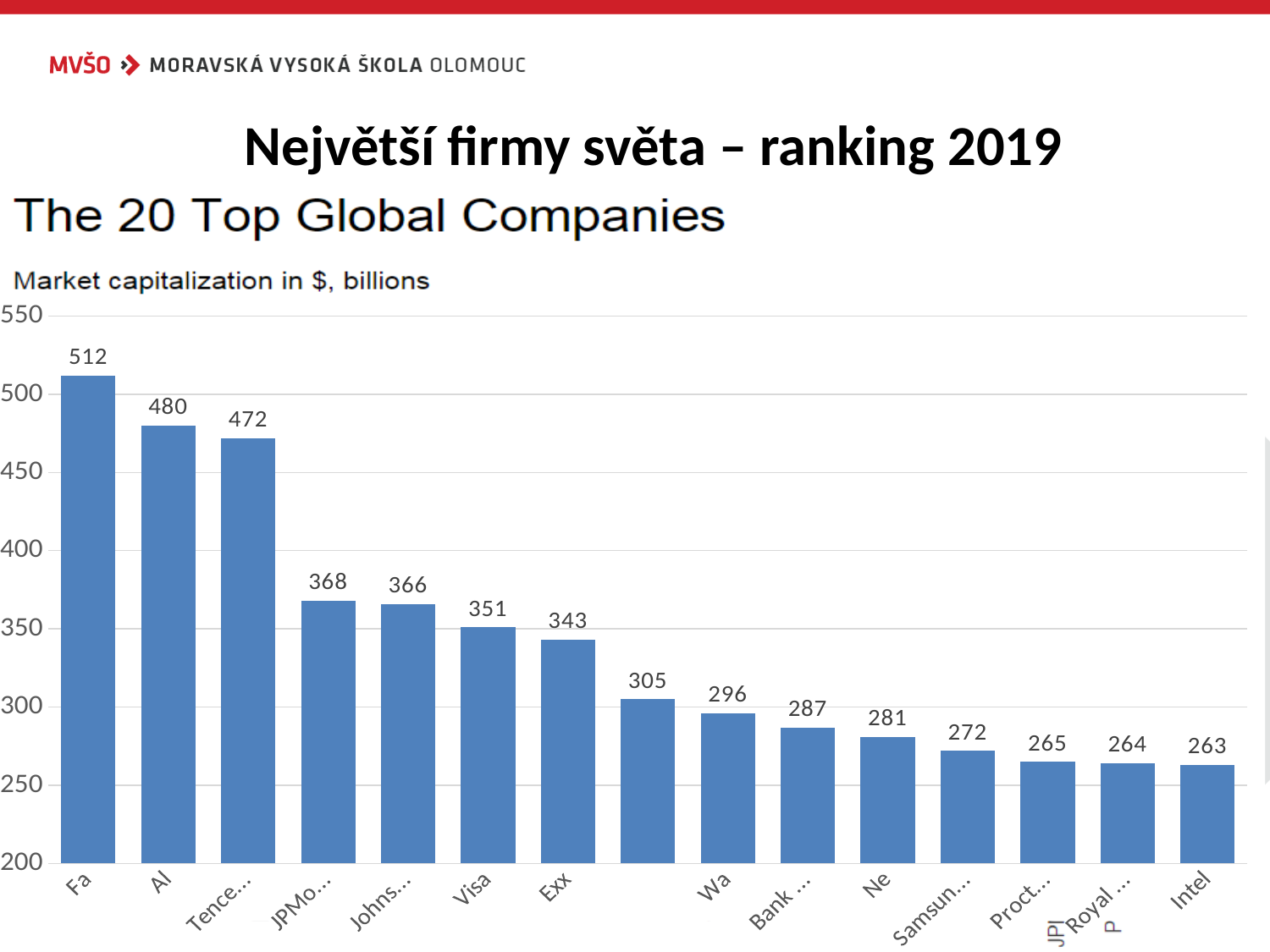
What is the difference between the value for Visa and the value for Intel? 88 What is the market capitalization value shown for Visa? 351 Which bar has the lowest value in the chart? Intel (263) Do the values rise or fall from left to right along the x axis? fall What is the value of the first (leftmost) bar, labelled "Fa"? 512 What kind of chart is shown on the slide? bar chart What is the market capitalization value shown for Intel? 263 Which is larger, the value for Visa or the value for Intel? Visa How many bars are plotted in the chart? 15 Which bar has the highest value in the chart? Fa (512) Is the value for Visa greater or less than 400? less What unit is the market capitalization measured in, according to the chart subtitle? $, billions